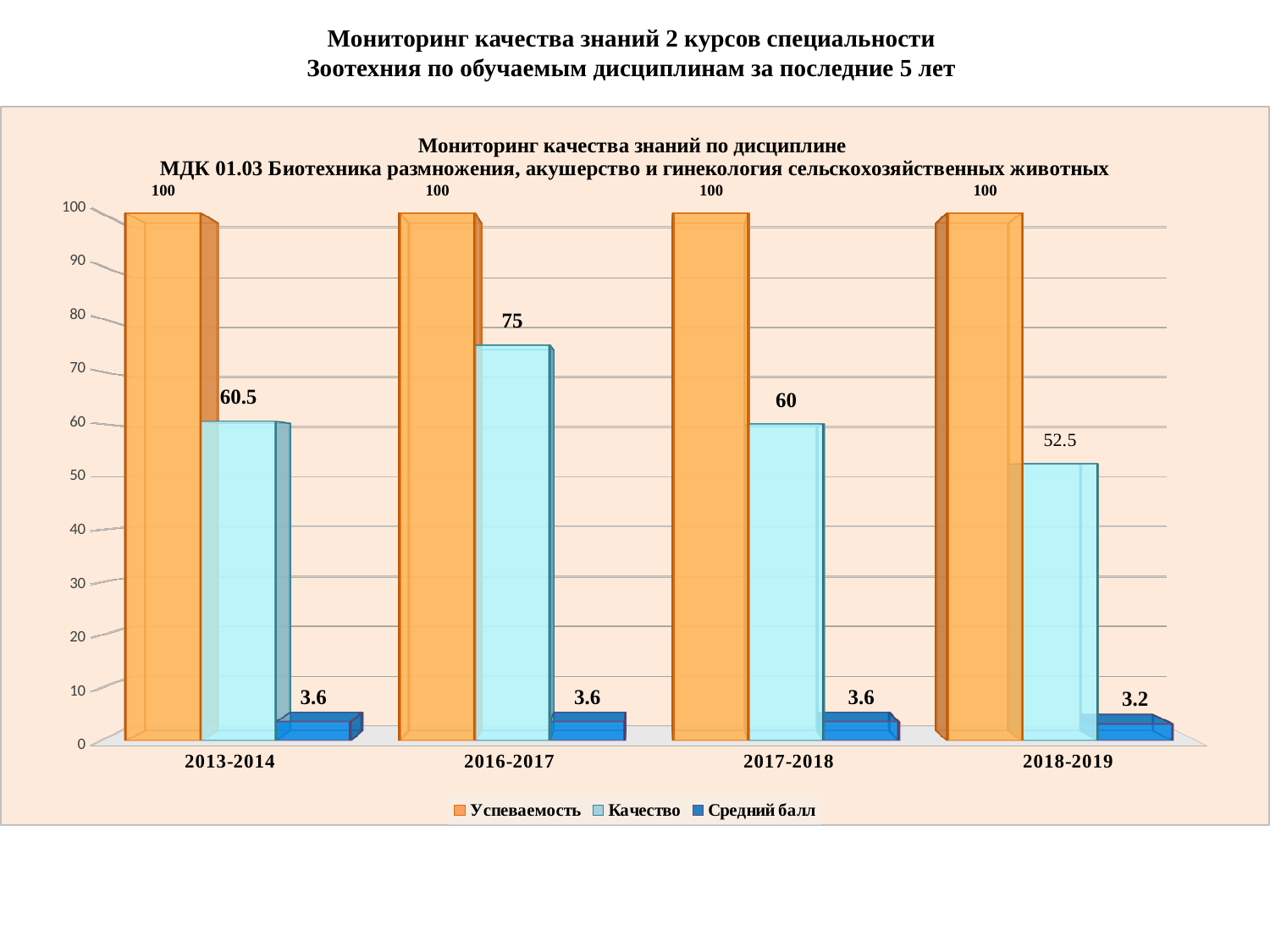
What is the value of Средний балл for 2018-2019? 3.2 What kind of chart is shown? bar chart How many year categories are shown on the x axis? 4 What is the value of Качество for 2013-2014? 60.5 How many series does the legend list? 3 In which year is Качество lowest? 2018-2019 Which is larger, Качество in 2013-2014 or in 2017-2018? 2013-2014 What is the value of Успеваемость for 2017-2018? 100 What is the value of Качество for 2016-2017? 75 Which series is shown in orange in the legend? Успеваемость What is the difference between Качество in 2016-2017 and 2018-2019? 22.5 In which year is Качество highest? 2016-2017